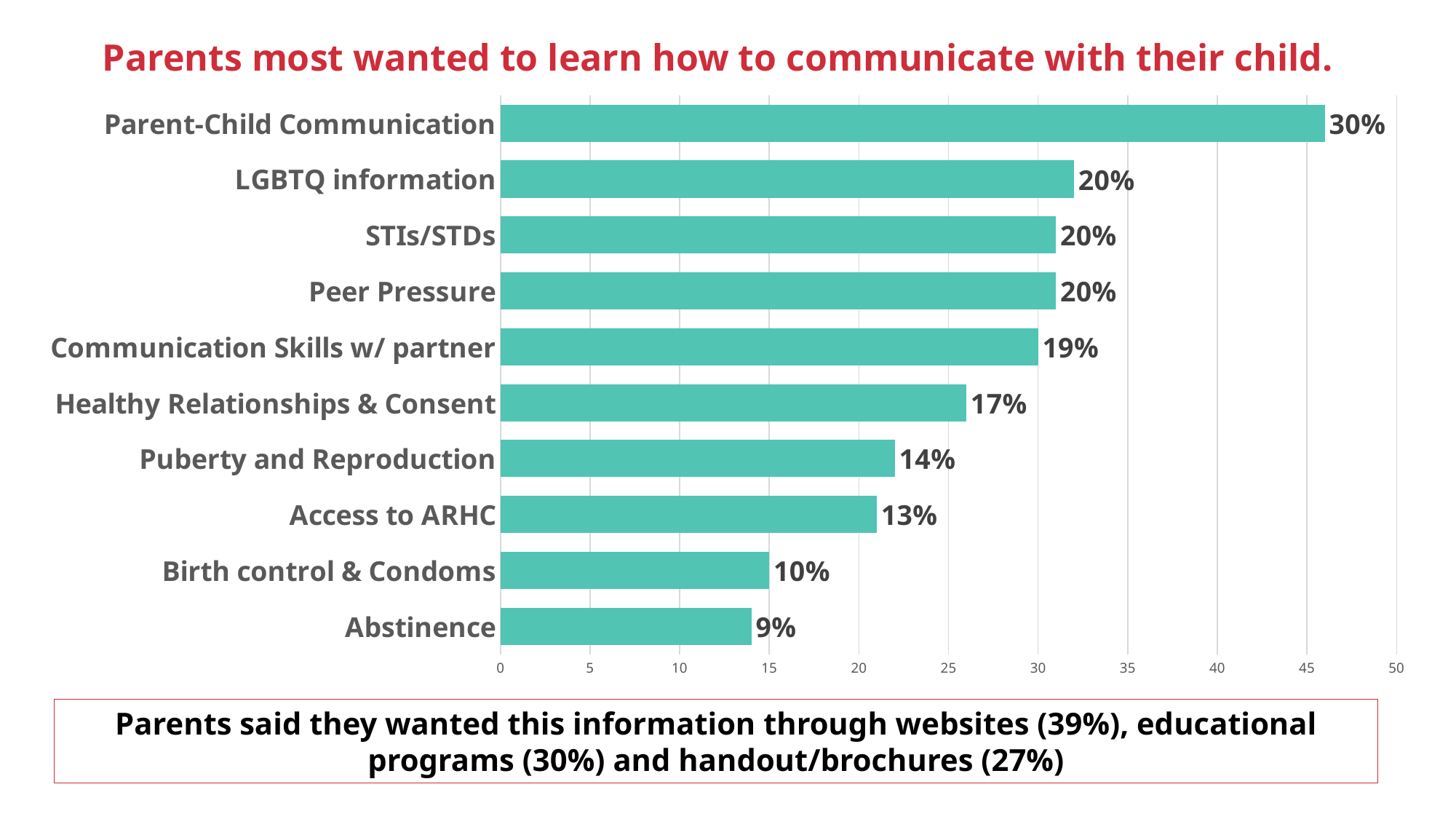
What is the value for Healthy Relationships & Consent? 17% What is the difference between the values for Parent-Child Communication and Abstinence? 21% Is the bar for Abstinence greater or less than 20 on the axis? less Is the bar for Parent-Child Communication greater or less than 40 on the axis? greater What is the title of the slide above the chart? Parents most wanted to learn how to communicate with their child. How many categories are shown in the chart? 10 What kind of chart is shown on the slide? Bar chart Which category has the lowest value? Abstinence What is the value for Access to ARHC? 13% Which category has the highest value? Parent-Child Communication Which is larger, the value for Healthy Relationships & Consent or the value for Puberty and Reproduction? Healthy Relationships & Consent What is the value for Parent-Child Communication? 30%